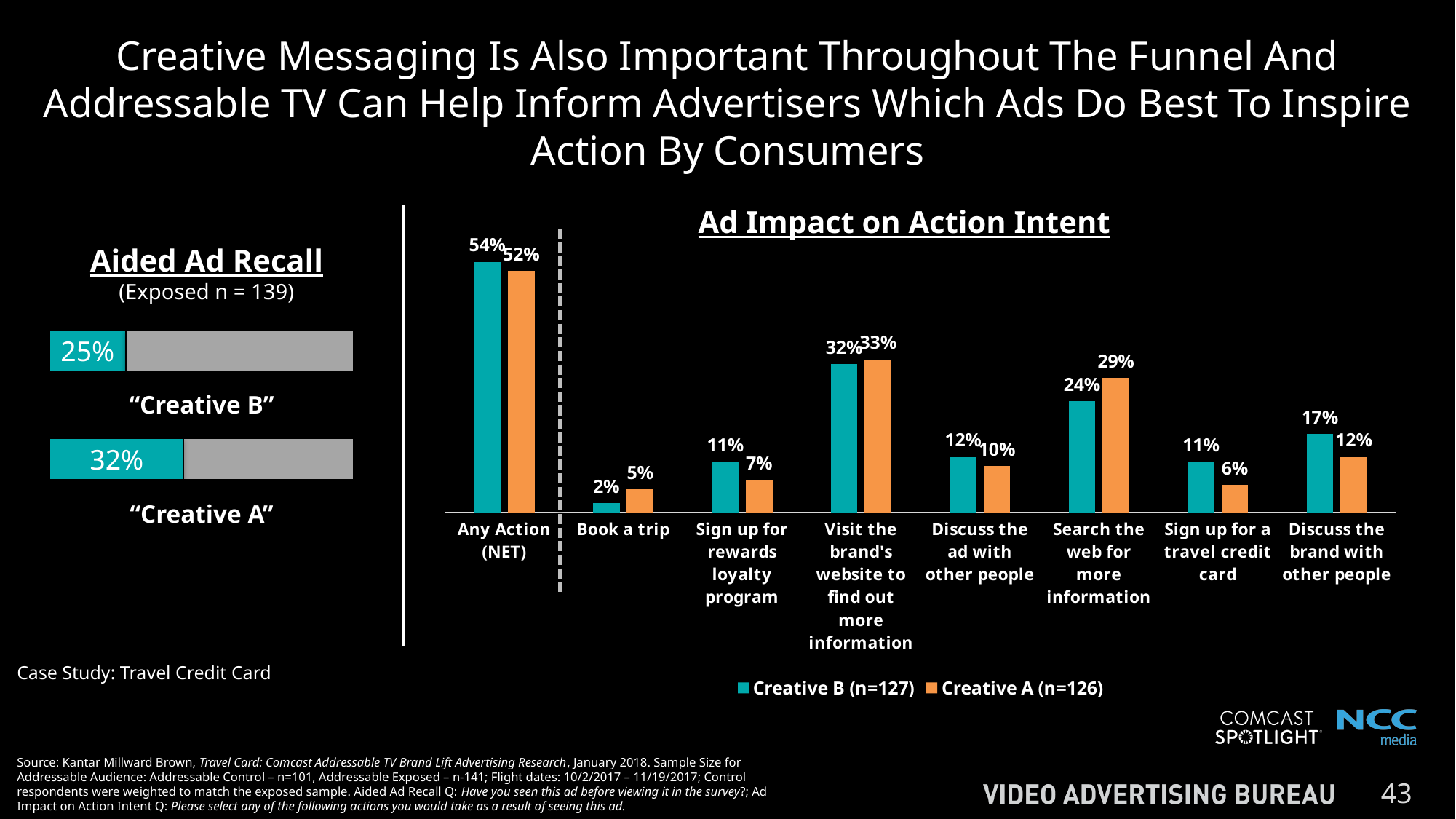
In the Ad Impact on Action Intent chart, what is the value for Creative A for Search the web for more information? 29% In the Aided Ad Recall chart, what is the difference between Creative A and Creative B? 7% In the Aided Ad Recall chart, what is the value for Creative B? 25% In the Ad Impact on Action Intent chart, which category has the highest value for Creative A? Any Action (NET) In the Aided Ad Recall chart, what is the value for Creative A? 32% In the Ad Impact on Action Intent chart, what is the value for Creative B for Discuss the brand with other people? 17% In the Ad Impact on Action Intent chart, what is the difference between Creative B and Creative A for Sign up for a travel credit card? 5% In the Ad Impact on Action Intent chart, which is larger for Book a trip: Creative B or Creative A? Creative A In the Ad Impact on Action Intent chart, how many categories are shown on the x axis? 8 In the Ad Impact on Action Intent chart, which category has the lowest value for Creative B? Book a trip In the Ad Impact on Action Intent chart, what is the value for Creative B for Any Action (NET)? 54% In the Ad Impact on Action Intent chart, how many series does the legend list? 2